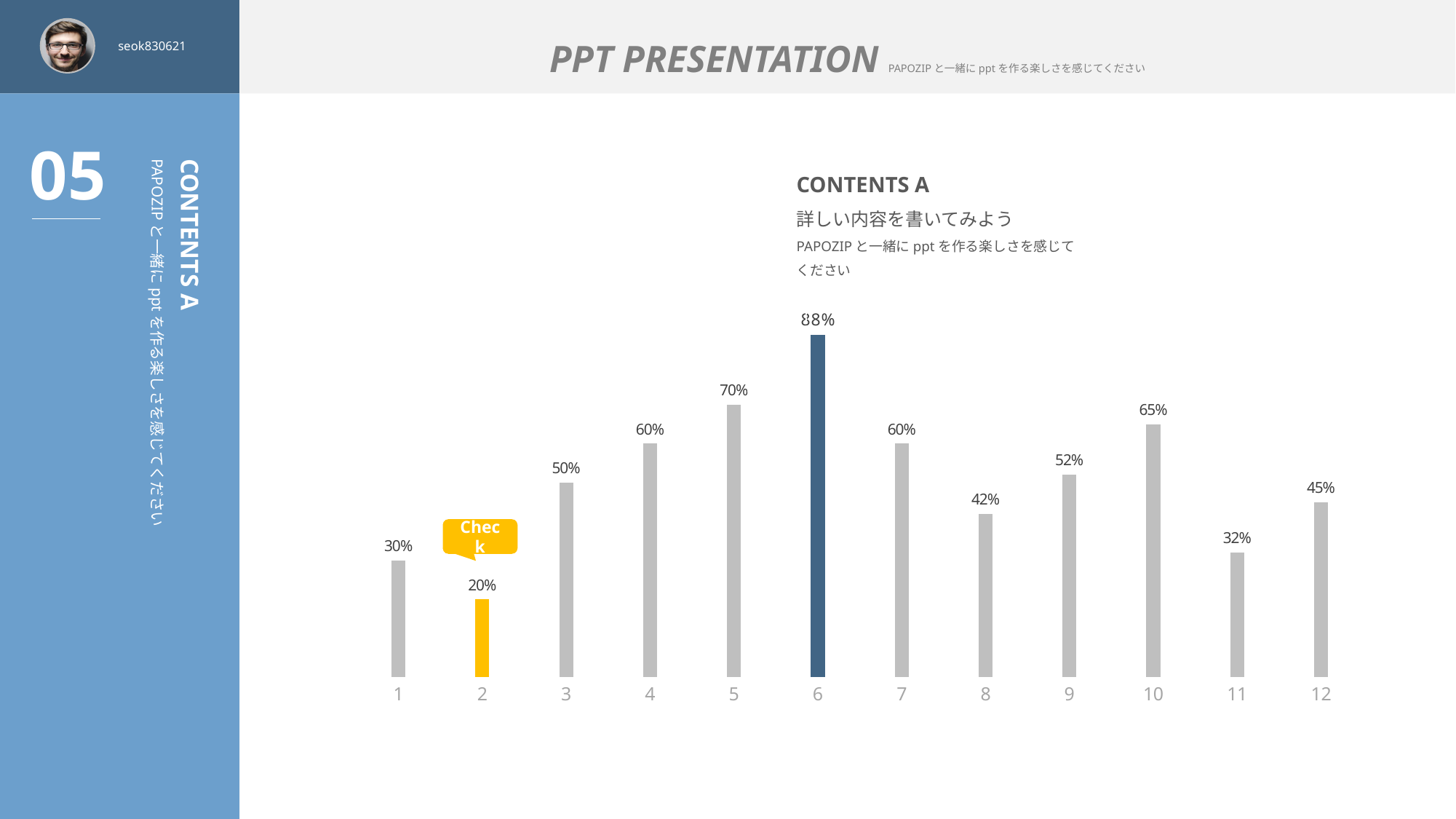
How many categories are shown on the x axis? 12 What is the difference between the values for category 6 and category 5? 18% What kind of chart is shown on the slide? bar chart What is the value for category 6? 88% What is the difference between the values for category 10 and category 12? 20% What is the value for category 11? 32% What is the value for category 9? 52% Which category's bar is highlighted in yellow with a 'Check' callout? 2 Which is larger, the value for category 8 or the value for category 12? 12 Which category has the highest value? 6 Which category has the lowest value? 2